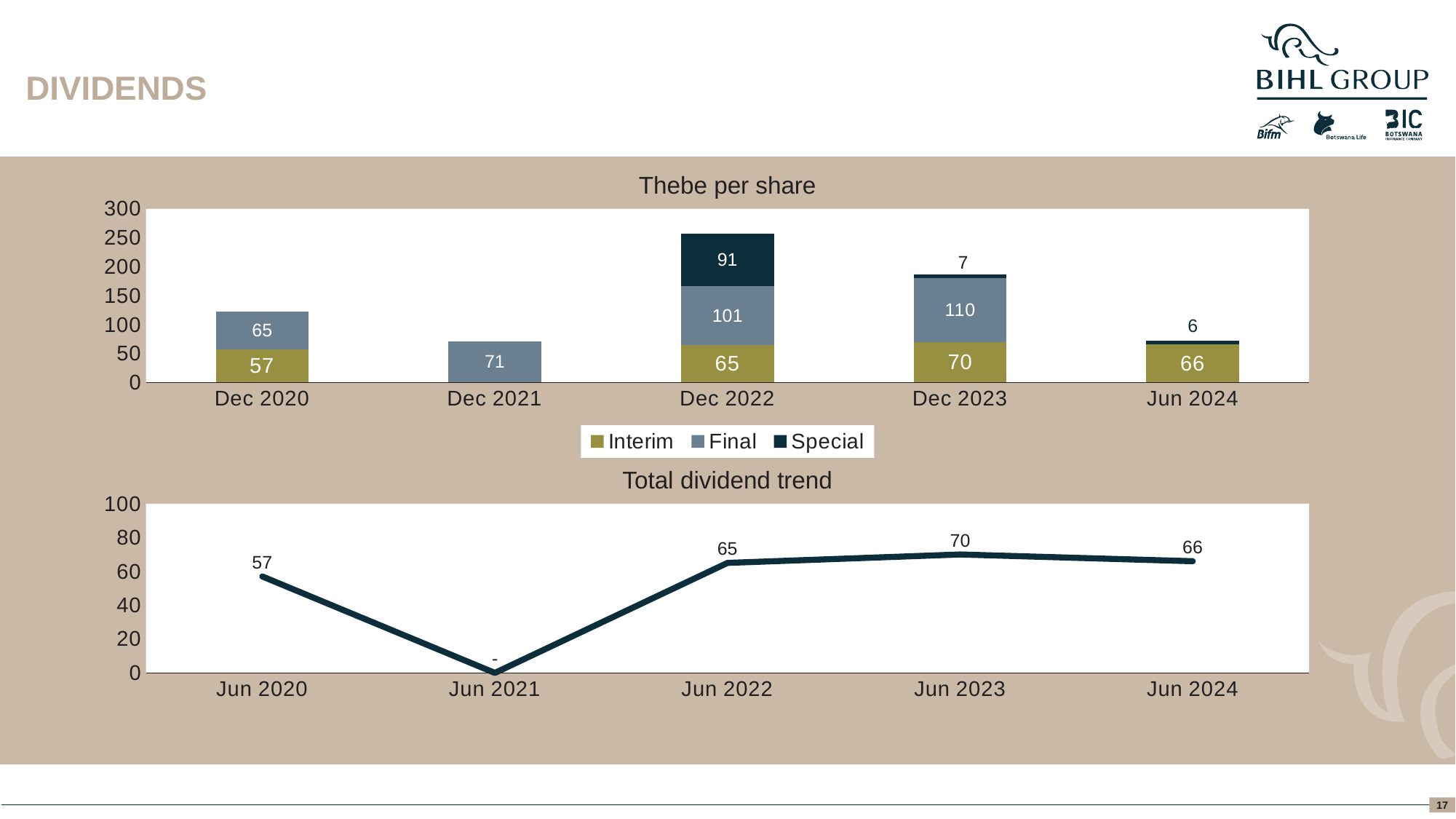
In the 'Thebe per share' chart, what is the Special value for Dec 2022? 91 In the 'Total dividend trend' chart, which period has the highest value? Jun 2023 What kind of chart is 'Total dividend trend'? Line chart In the 'Thebe per share' chart, which period has the tallest stacked bar? Dec 2022 In the 'Total dividend trend' chart, what is the value for Jun 2023? 70 In the 'Thebe per share' chart, how many series does the legend list? 3 In the 'Thebe per share' chart, what is the total of the stacked bar for Dec 2022? 257 In the 'Thebe per share' chart, what is the Interim value for Dec 2020? 57 In the 'Thebe per share' chart, what is the difference between the Final values for Dec 2023 and Dec 2022? 9 In the 'Total dividend trend' chart, how many periods are shown on the x axis? 5 In the 'Thebe per share' chart, what is the total of the stacked bar for Dec 2023? 187 In the 'Thebe per share' chart, what is the Final value for Dec 2023? 110